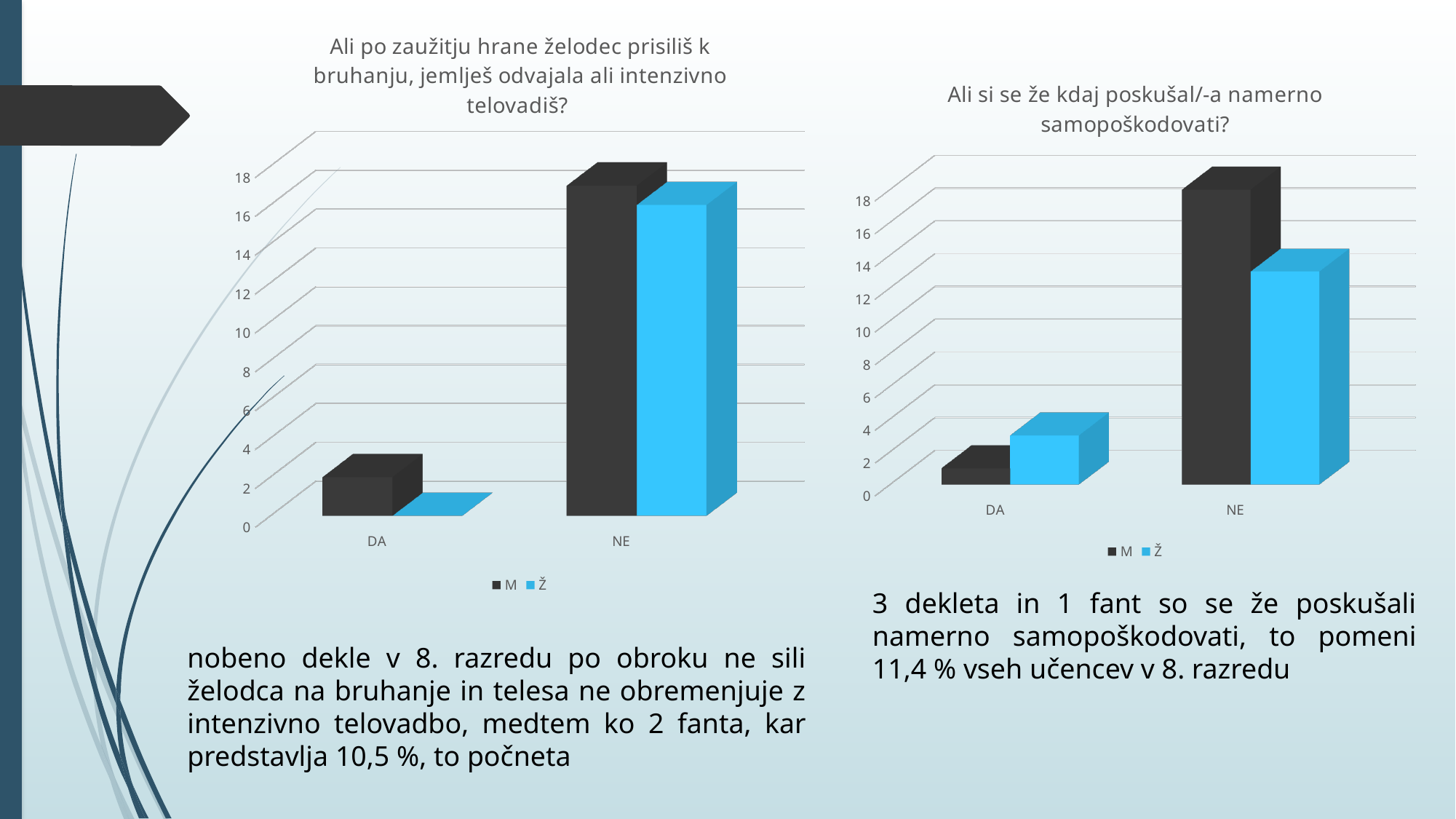
In the right chart, is the value for Ž in category NE greater or less than 10? greater In the left chart, is the value for Ž in category NE greater or less than 10? greater In the left chart, which category has the highest value for series M? NE In the left chart, how many categories are shown on the x axis? 2 In the right chart, which series has the larger value in category NE, M or Ž? M In the right chart, which category has the lowest value for series Ž? DA In the right chart, which series has the larger value in category DA, M or Ž? Ž In the left chart, is the value for M in category DA greater or less than 6? less What kind of chart is the left chart titled "Ali po zaužitju hrane želodec prisiliš k bruhanju, jemlješ odvajala ali intenzivno telovadiš?"? bar chart How many series does the legend of the right chart "Ali si se že kdaj poskušal/-a namerno samopoškodovati?" list? 2 What are the two legend entries of the left chart? M and Ž